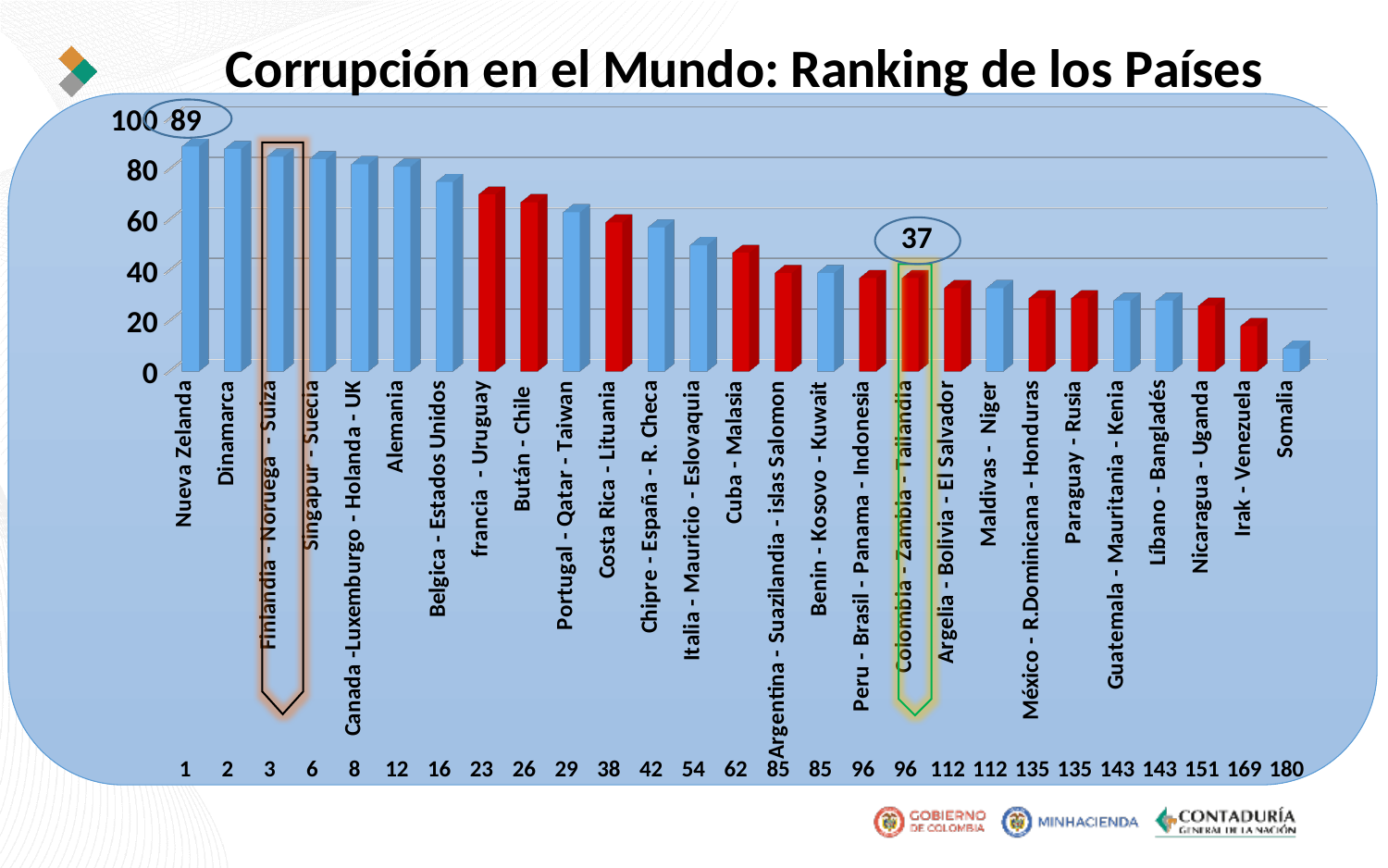
Is the value for Somalia greater or less than 20? less What is the value shown for Nueva Zelanda? 89 Do the values rise or fall from left to right along the x axis? fall What is the title of the chart? Corrupción en el Mundo: Ranking de los Países Which has a larger value, Alemania or Somalia? Alemania What is the difference between the value for Nueva Zelanda and the value for Colombia - Zambia - Tailandia? 52 Which category has the lowest bar? Somalia What kind of chart is shown on the slide? bar chart Is the value for Alemania greater or less than 60? greater What is the value shown for Colombia - Zambia - Tailandia? 37 How many categories are plotted on the chart? 27 Which has a larger value, francia - Uruguay or Cuba - Malasia? francia - Uruguay